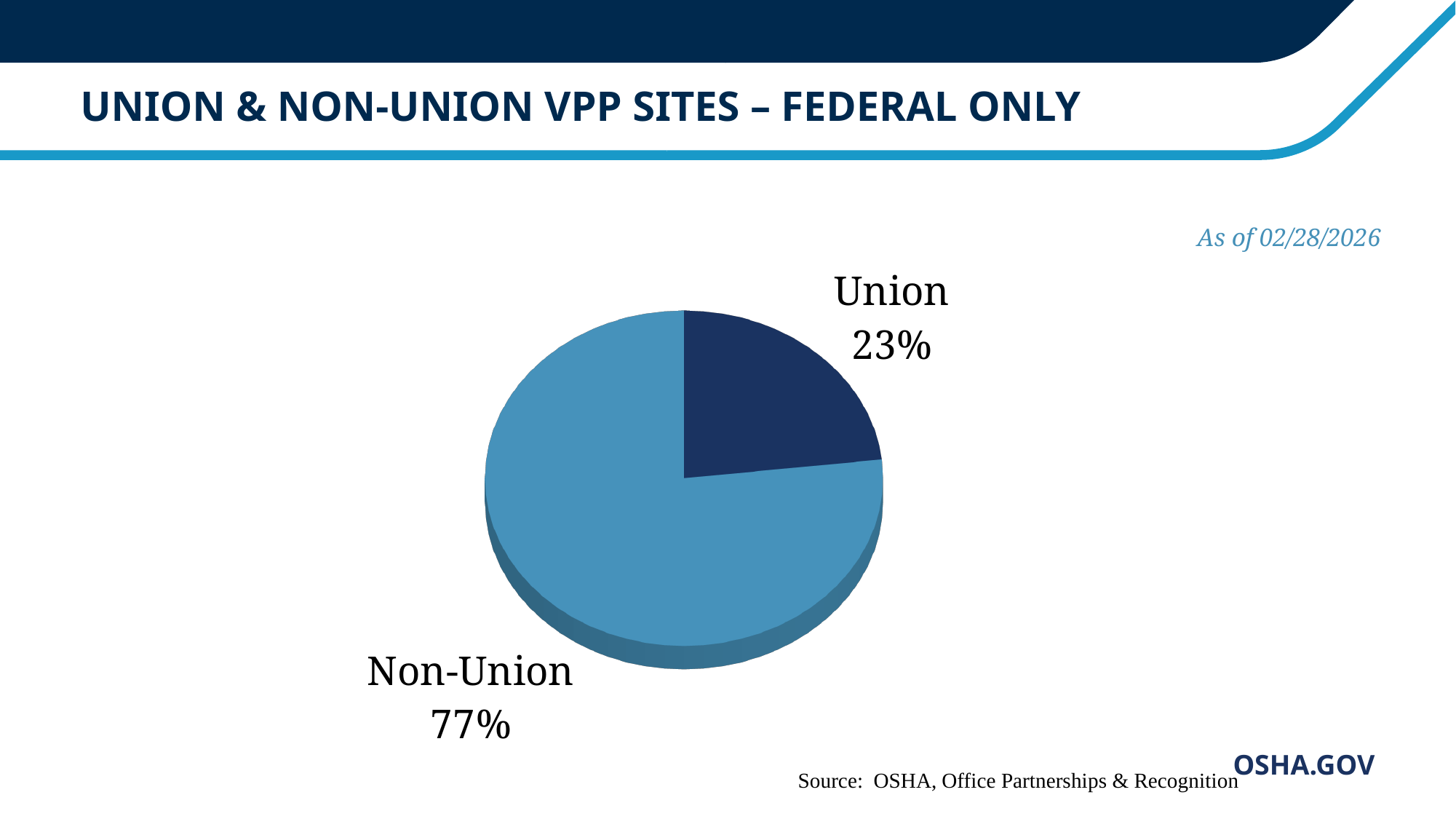
Which slice is the largest? Non-Union Which slice is the smallest? Union What share of the pie is Union? 23% What date is the chart data as of? 02/28/2026 What kind of chart is shown on the slide? pie chart What is the difference in percentage points between the Non-Union and Union slices? 54 Which is larger, the Union slice or the Non-Union slice? Non-Union What is the title of the slide? UNION & NON-UNION VPP SITES – FEDERAL ONLY What share of the pie is Non-Union? 77% How many slices does the pie chart have? 2